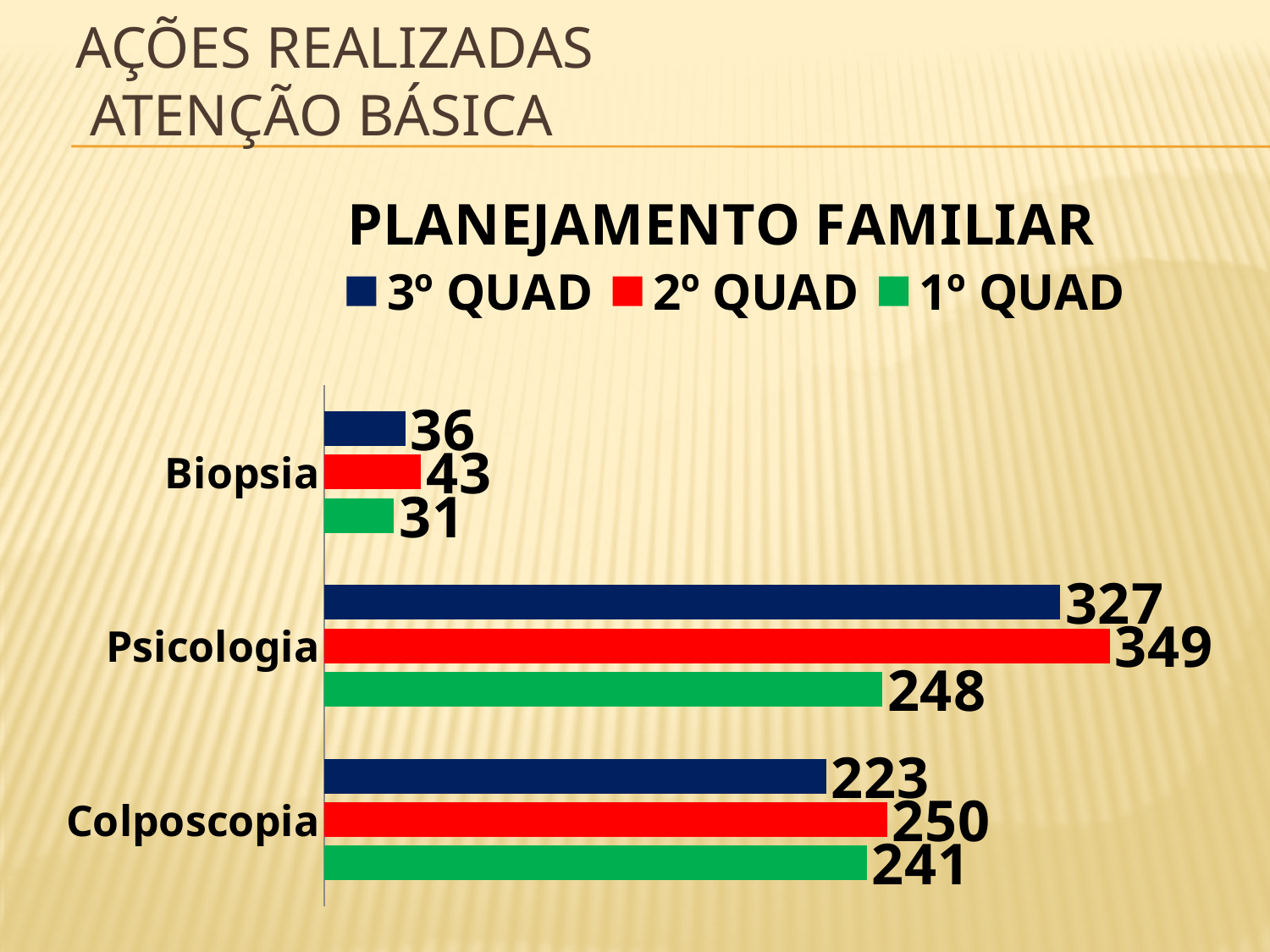
What kind of chart is shown on the slide? bar chart What is the value for Biopsia in the 1º QUAD series? 31 What is the value for Colposcopia in the 3º QUAD series? 223 How many series does the legend list? 3 Which is larger for Colposcopia: the 1º QUAD value or the 3º QUAD value? 1º QUAD How many categories are shown on the chart? 3 What is the difference between the 2º QUAD and 1º QUAD values for Psicologia? 101 What is the value for Psicologia in the 2º QUAD series? 349 What is the difference between the 2º QUAD and 3º QUAD values for Colposcopia? 27 What is the title of the chart? PLANEJAMENTO FAMILIAR Which category has the highest value in the 3º QUAD series? Psicologia Which category has the lowest value in the 2º QUAD series? Biopsia